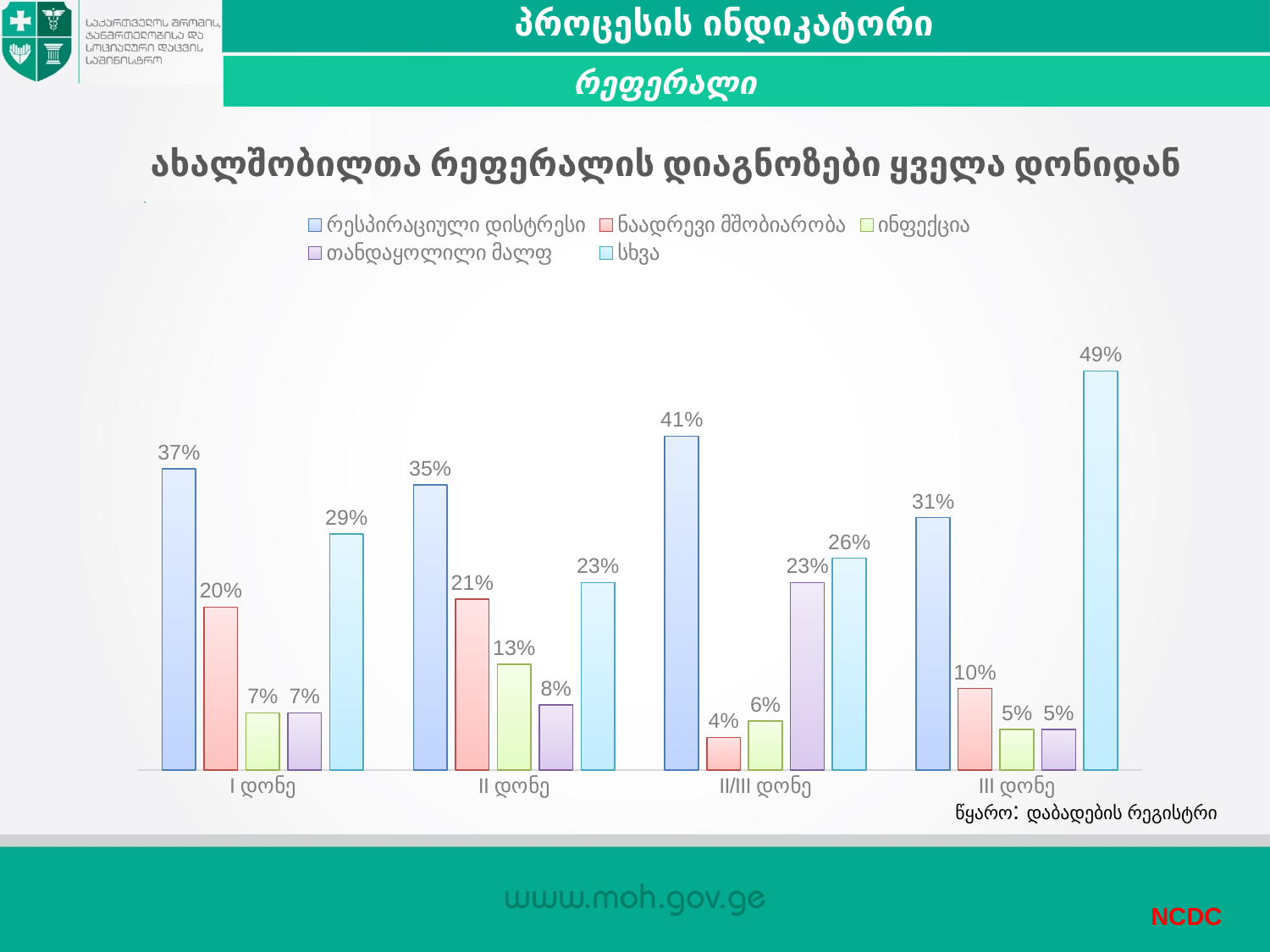
How many categories are shown on the x axis? 4 Which is larger in II დონე: ნაადრევი მშობიარობა or სხვა? სხვა What kind of chart is shown on the slide? Bar chart What is the value for რესპირაციული დისტრესი in I დონე? 37% What is the value for სხვა in III დონე? 49% What is the value for თანდაყოლილი მალფ in II დონე? 8% What is the value for ნაადრევი მშობიარობა in II/III დონე? 4% Which category has the highest value for რესპირაციული დისტრესი? II/III დონე What is the source noted below the chart? დაბადების რეგისტრი How many series does the legend list? 5 What is the difference between სხვა and რესპირაციული დისტრესი in III დონე? 18% Which category has the lowest value for ინფექცია? III დონე